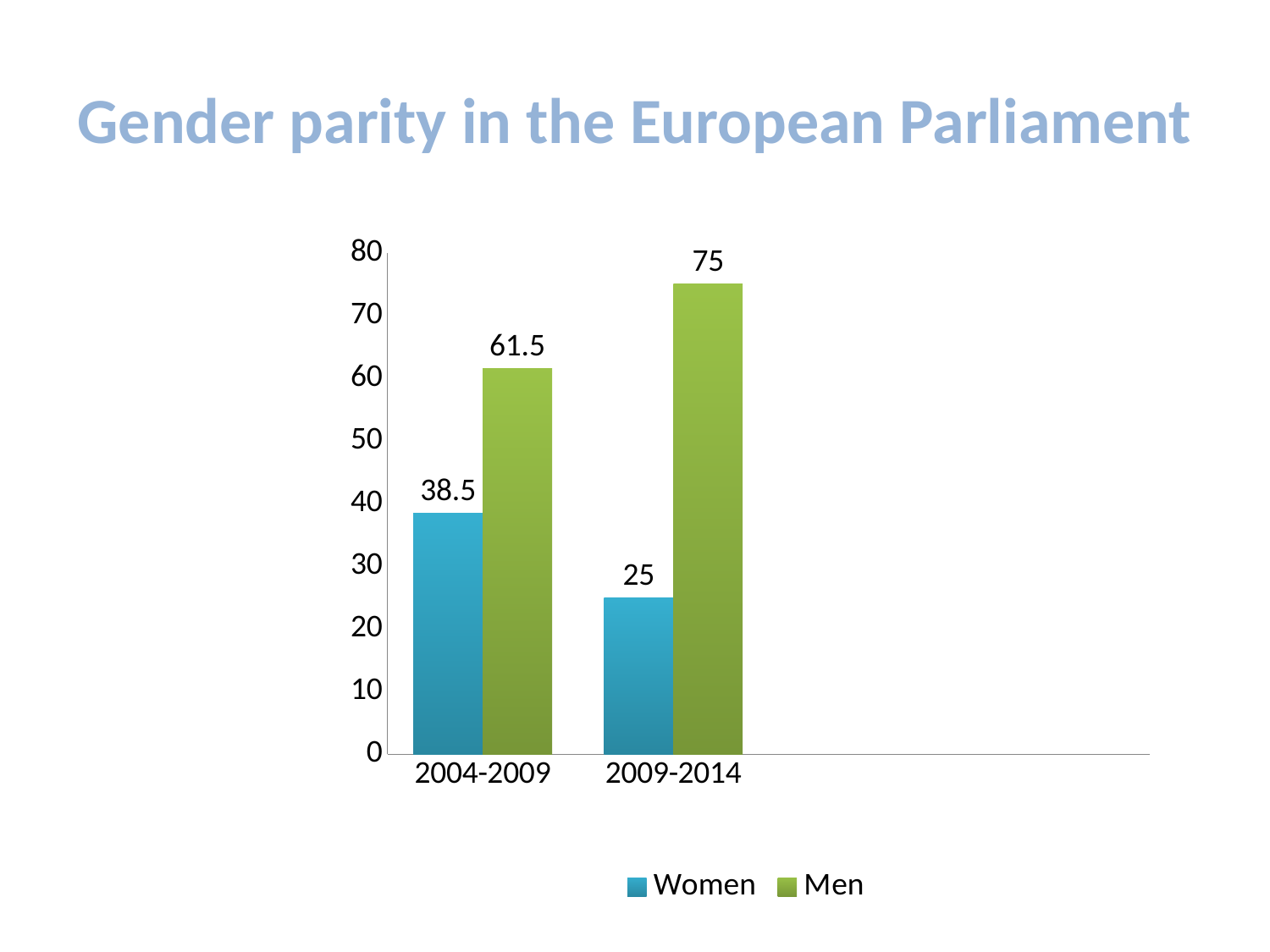
Which period has the highest value for Men? 2009-2014 Do the values for Women rise or fall from 2004-2009 to 2009-2014? Fall What is the value for Women in 2004-2009? 38.5 How many series does the legend list? 2 What is the difference between the Men and Women values in 2004-2009? 23 What is the value for Women in 2009-2014? 25 How many periods are shown on the x axis? 2 Which period has the lowest value for Women? 2009-2014 What is the value for Men in 2009-2014? 75 Which is larger in 2009-2014, the value for Women or the value for Men? Men What kind of chart is shown on the slide? Bar chart What is the value for Men in 2004-2009? 61.5